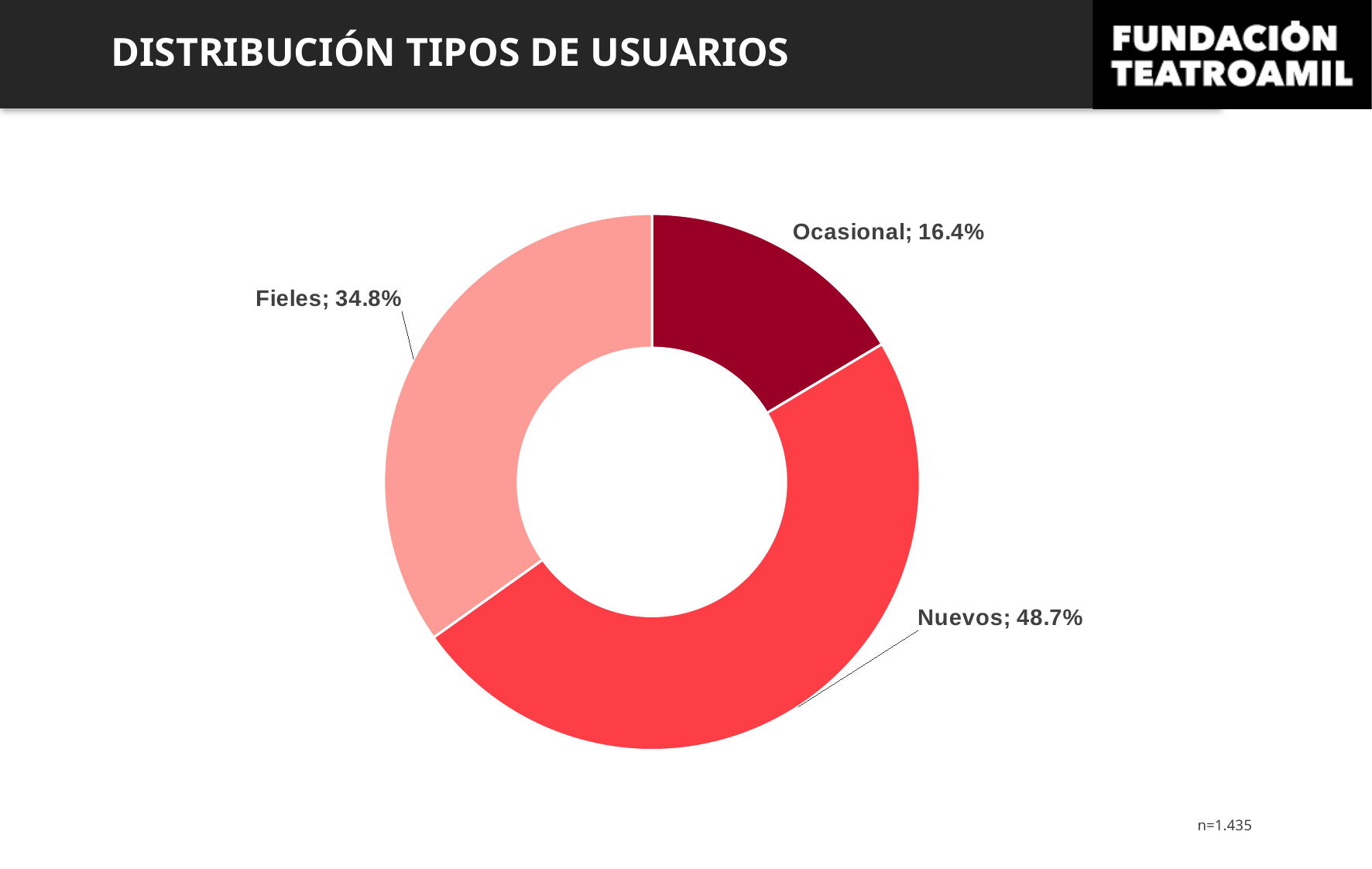
Which is larger, the share of Fieles or the share of Ocasional? Fieles What percentage of users are Ocasional? 16.4% Which user type has the largest share? Nuevos How many user types are shown in the chart? 3 What is the difference in percentage points between Fieles and Ocasional? 18.4 What kind of chart is shown on the slide? Doughnut (pie) chart What is the difference in percentage points between Nuevos and Fieles? 13.9 What is the title of the slide? DISTRIBUCIÓN TIPOS DE USUARIOS What sample size (n) is noted on the slide? n=1.435 Which user type has the smallest share? Ocasional What percentage of users are Nuevos? 48.7% What percentage of users are Fieles? 34.8%